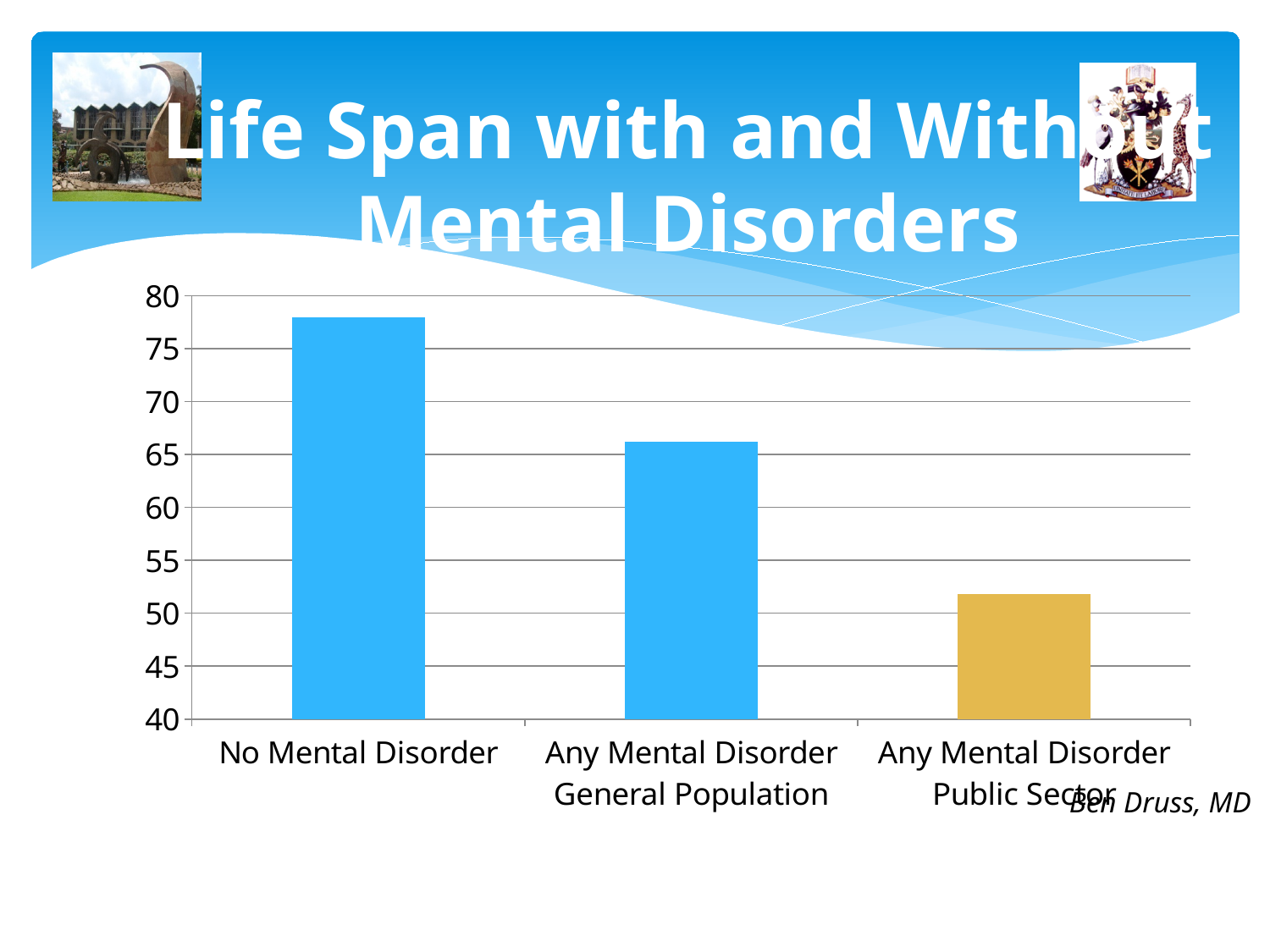
Which bar is coloured differently (gold) from the other bars? Any Mental Disorder Public Sector Is the value for No Mental Disorder greater or less than 75? greater Which category has the highest value? No Mental Disorder How many categories are plotted on the chart? 3 Is the value for Any Mental Disorder General Population greater or less than 60? greater Do the values rise or fall from left to right across the categories? fall Is the value for Any Mental Disorder Public Sector greater or less than 55? less Which is larger, the value for Any Mental Disorder General Population or the value for Any Mental Disorder Public Sector? Any Mental Disorder General Population Which category has the lowest value? Any Mental Disorder Public Sector What kind of chart is shown on the slide? bar chart What is the title of the slide containing the chart? Life Span with and Without Mental Disorders